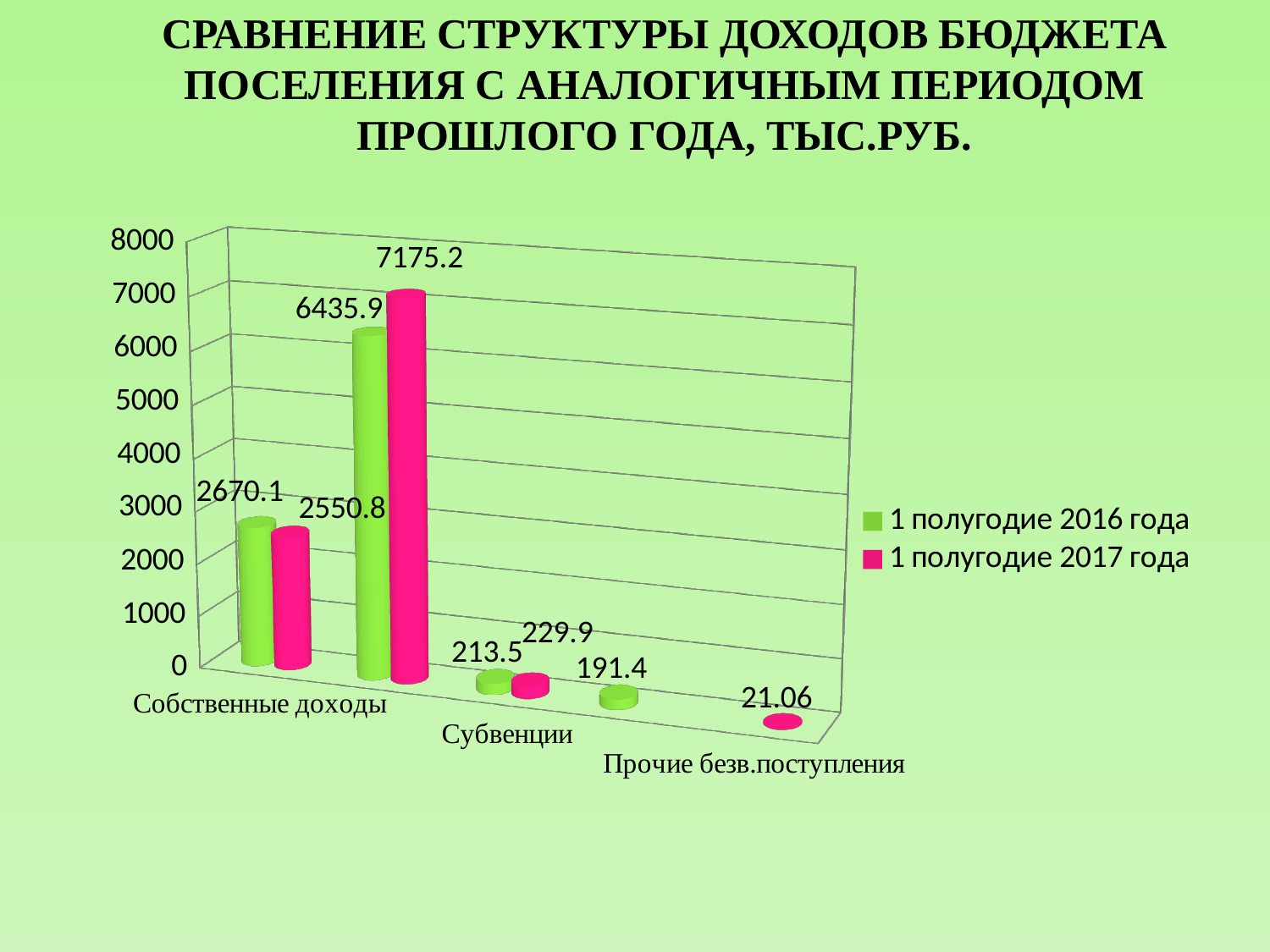
What is the value for Субвенции in 1 полугодие 2017 года? 229.9 What is the lowest value shown on the chart? 21.06 What kind of chart is shown on the slide? Bar chart Which is larger for Субвенции: the 1 полугодие 2016 года value or the 1 полугодие 2017 года value? 1 полугодие 2017 года What is the value for Прочие безв.поступления in 1 полугодие 2017 года? 21.06 What is the value for Собственные доходы in 1 полугодие 2016 года? 2670.1 What is the value for Собственные доходы in 1 полугодие 2017 года? 2550.8 How many category groups are plotted on the chart? 5 How many series does the legend list? 2 What is the highest value shown on the chart? 7175.2 What is the difference between the 2016 and 2017 values for Собственные доходы? 119.3